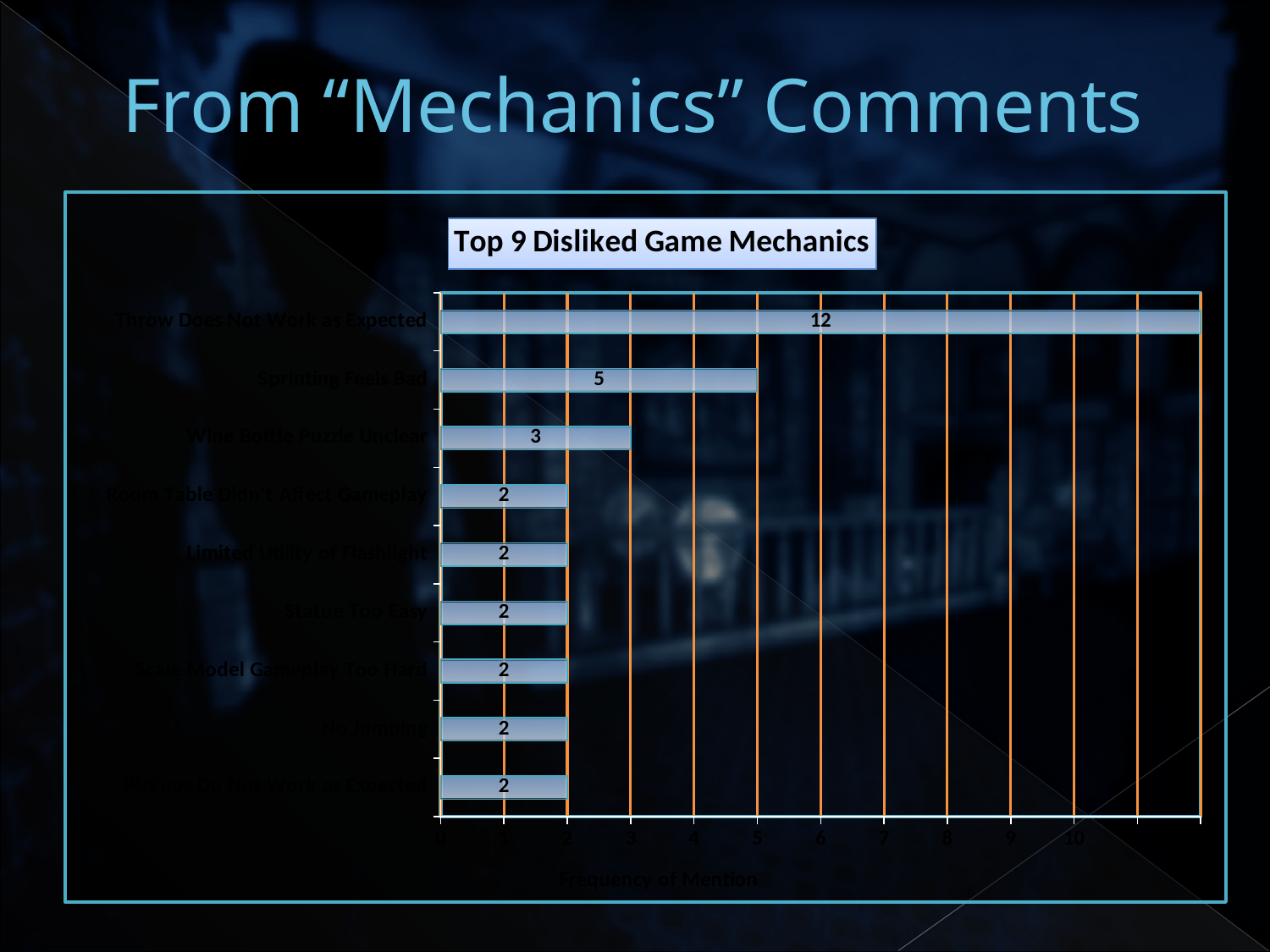
What is the value for "Statue Too Easy"? 2 What is the value for "Sprinting Feels Bad"? 5 What is the difference between the values for "Throw Does Not Work as Expected" and "Sprinting Feels Bad"? 7 What is the value for "Throw Does Not Work as Expected"? 12 Is the value for "Throw Does Not Work as Expected" greater or less than 10? greater Which is larger, the value for "Sprinting Feels Bad" or the value for "Wine Bottle Puzzle Unclear"? Sprinting Feels Bad What is the value for "Wine Bottle Puzzle Unclear"? 3 What type of chart is shown on the slide? Bar chart What is the label of the horizontal axis? Frequency of Mention What is the title of the chart? Top 9 Disliked Game Mechanics Which category has the highest frequency of mention? Throw Does Not Work as Expected How many categories are plotted in the chart? 9